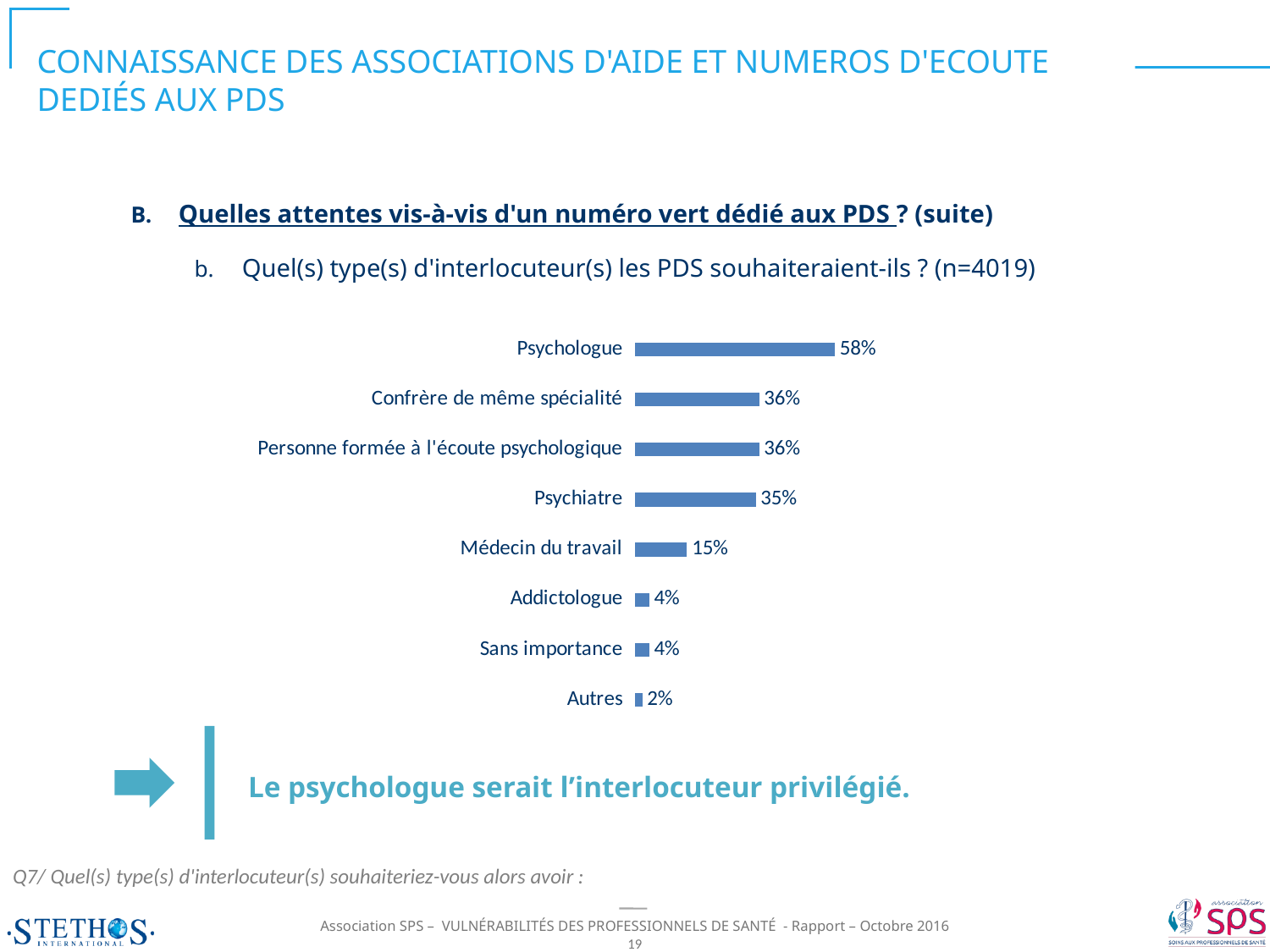
Which two categories both have a value of 36%? Confrère de même spécialité and Personne formée à l'écoute psychologique What percentage of respondents chose Psychologue? 58% Which category has the lowest value? Autres What is the difference between the values for Psychiatre and Médecin du travail? 20% How many categories are shown in the chart? 8 What is the value shown for Médecin du travail? 15% What percentage is shown for Psychiatre? 35% What type of chart is shown on the slide? Bar chart What is the difference between the values for Psychologue and Confrère de même spécialité? 22% Which category has the highest value? Psychologue Which is larger, the value for Psychiatre or the value for Médecin du travail? Psychiatre What is the value for Autres? 2%